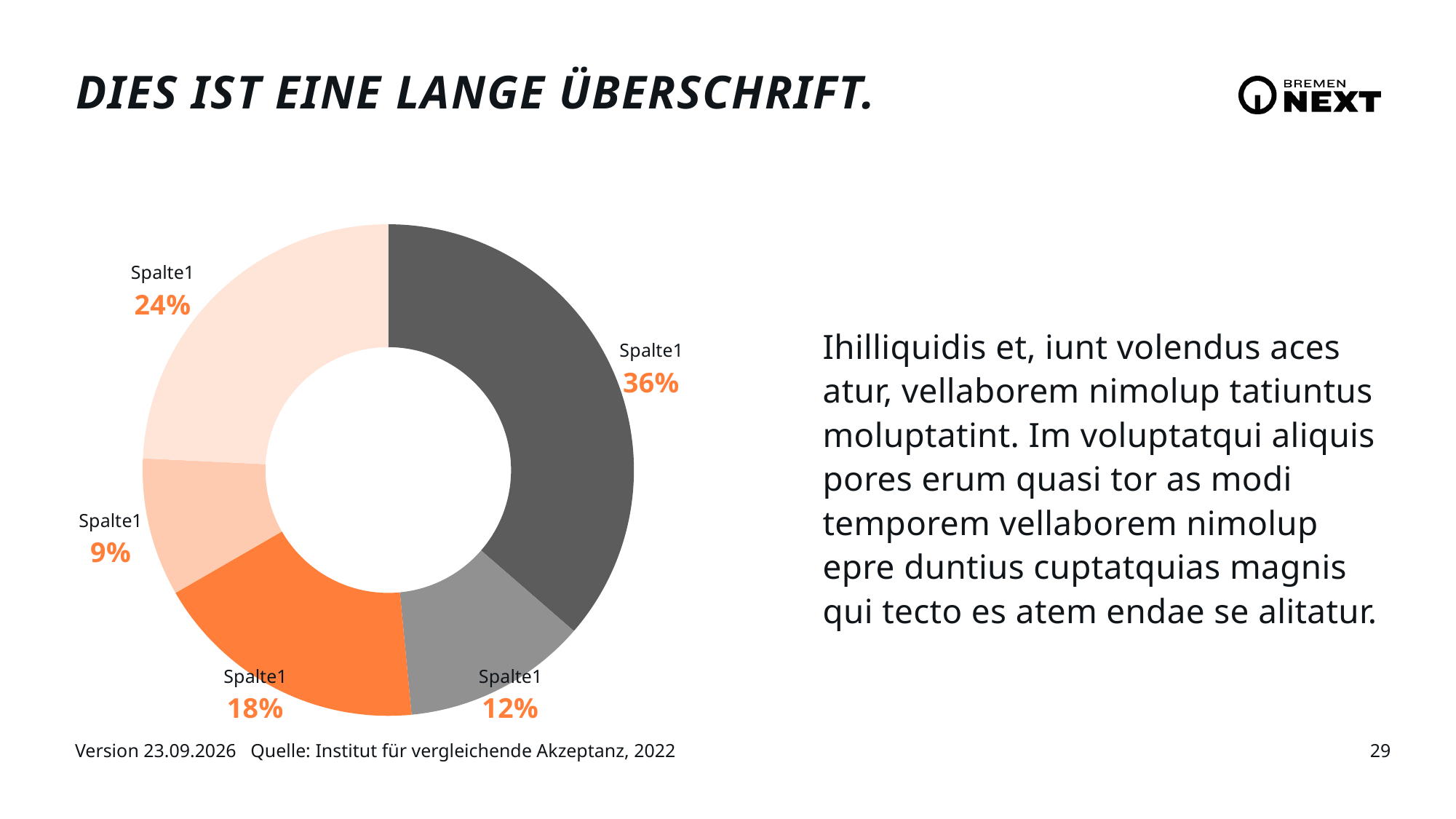
What is the largest percentage shown on the donut chart? 36% What is the smallest percentage shown on the donut chart? 9% What colour is the largest slice of the donut chart? dark grey What percentage is shown for the medium grey slice at the bottom right of the donut chart? 12% What is the difference in percentage points between the dark grey slice (36%) and the medium grey slice (12%)? 24 percentage points Which slice is larger: the bright orange slice or the medium grey slice? the bright orange slice (18%) What percentage is shown for the dark grey slice on the right of the donut chart? 36% How many slices does the donut chart have? 5 What percentage is shown for the lightest slice at the top left of the donut chart? 24% What kind of chart is shown on the slide? donut (pie) chart What label is shown next to every slice of the donut chart? Spalte1 What percentage is shown for the bright orange slice at the bottom left of the donut chart? 18%